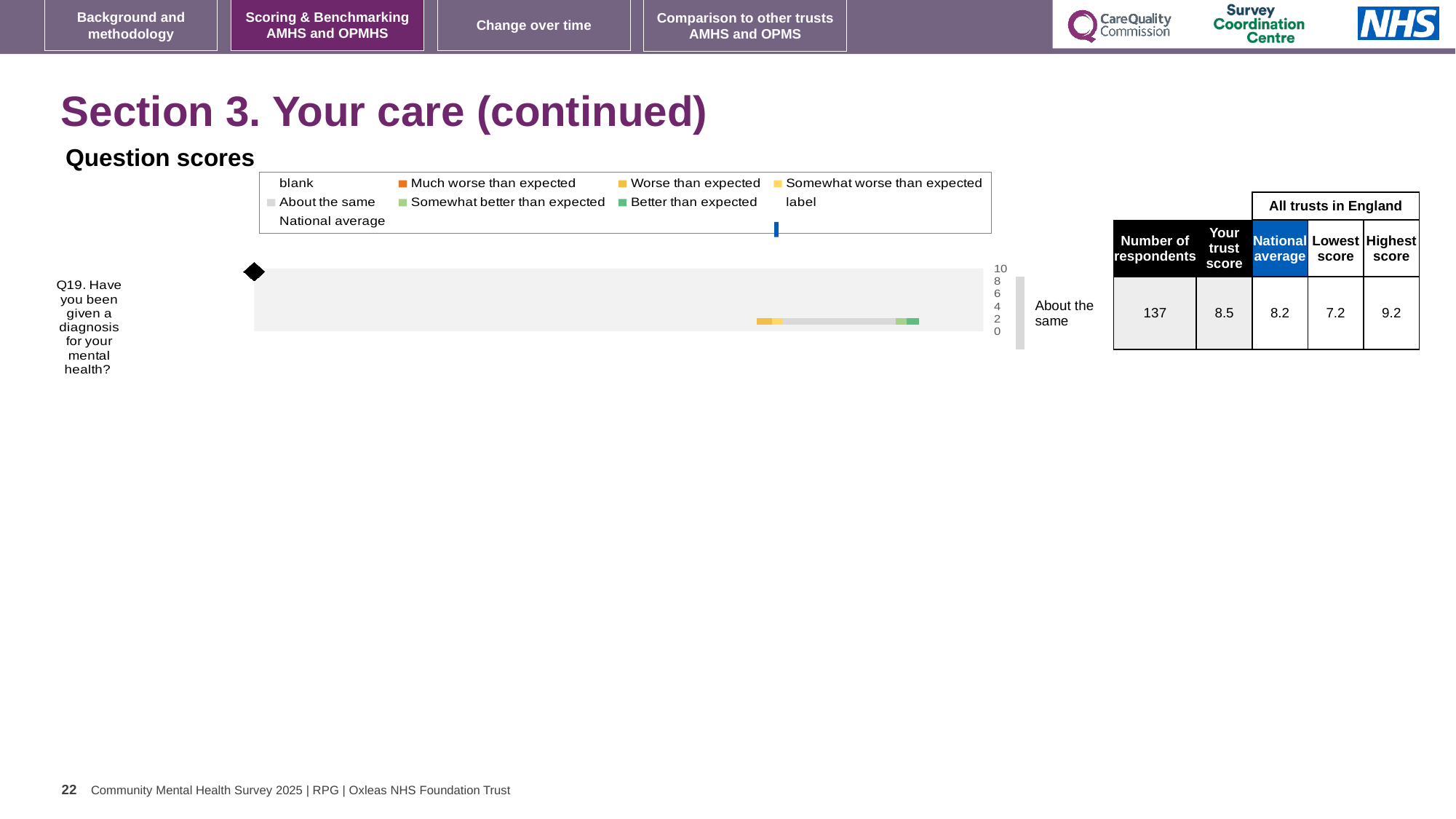
What is the difference between the highest score and the lowest score for Q19? 2.0 Which question is plotted in the Question scores chart? Q19. Have you been given a diagnosis for your mental health? What is the number of respondents for Q19? 137 What kind of chart is shown under 'Question scores'? bar chart What benchmark category is shown next to the bar for Q19? About the same What is the national average for Q19? 8.2 What is the highest score among all trusts in England for Q19? 9.2 What is the lowest score among all trusts in England for Q19? 7.2 What colour represents 'Much worse than expected' in the legend? orange Is your trust score for Q19 higher or lower than the national average? higher What is your trust score for Q19? 8.5 How many questions are plotted in the Question scores chart? 1